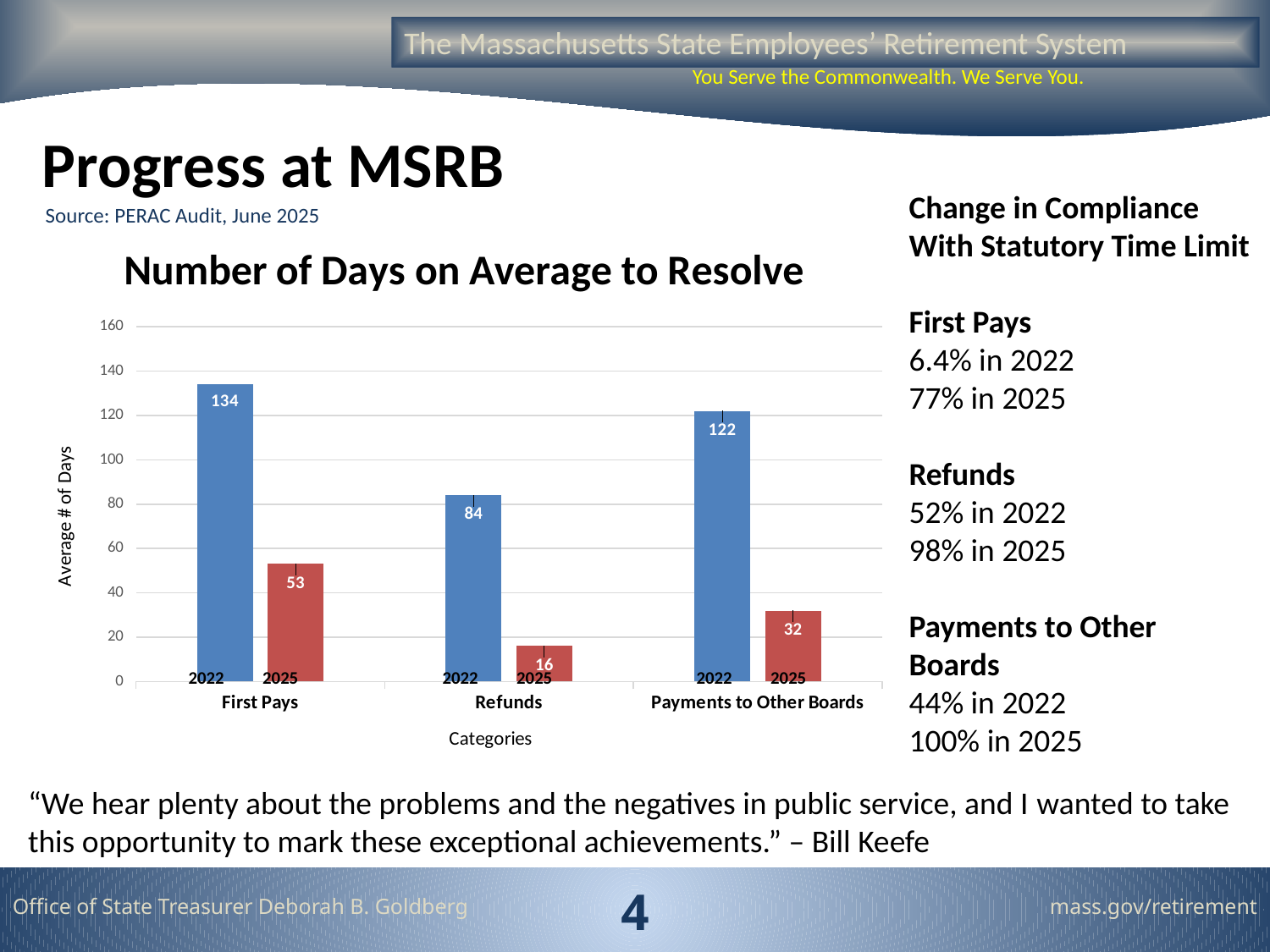
What is the difference between the 2022 and 2025 values for Payments to Other Boards? 90 Is the 2022 value for Refunds greater or less than 100? less What is the average number of days to resolve First Pays in 2022? 134 Which bar in the chart has the lowest value? Refunds 2025 What is the average number of days to resolve Refunds in 2025? 16 Which is larger: the 2025 value for First Pays or the 2025 value for Payments to Other Boards? First Pays 2025 How many categories are shown on the x axis of the chart? 3 What type of chart is shown on the slide? bar chart What is the average number of days to resolve Payments to Other Boards in 2022? 122 Which bar in the chart has the highest value? First Pays 2022 What is the title of the chart? Number of Days on Average to Resolve By how many days did the average time to resolve First Pays fall from 2022 to 2025? 81